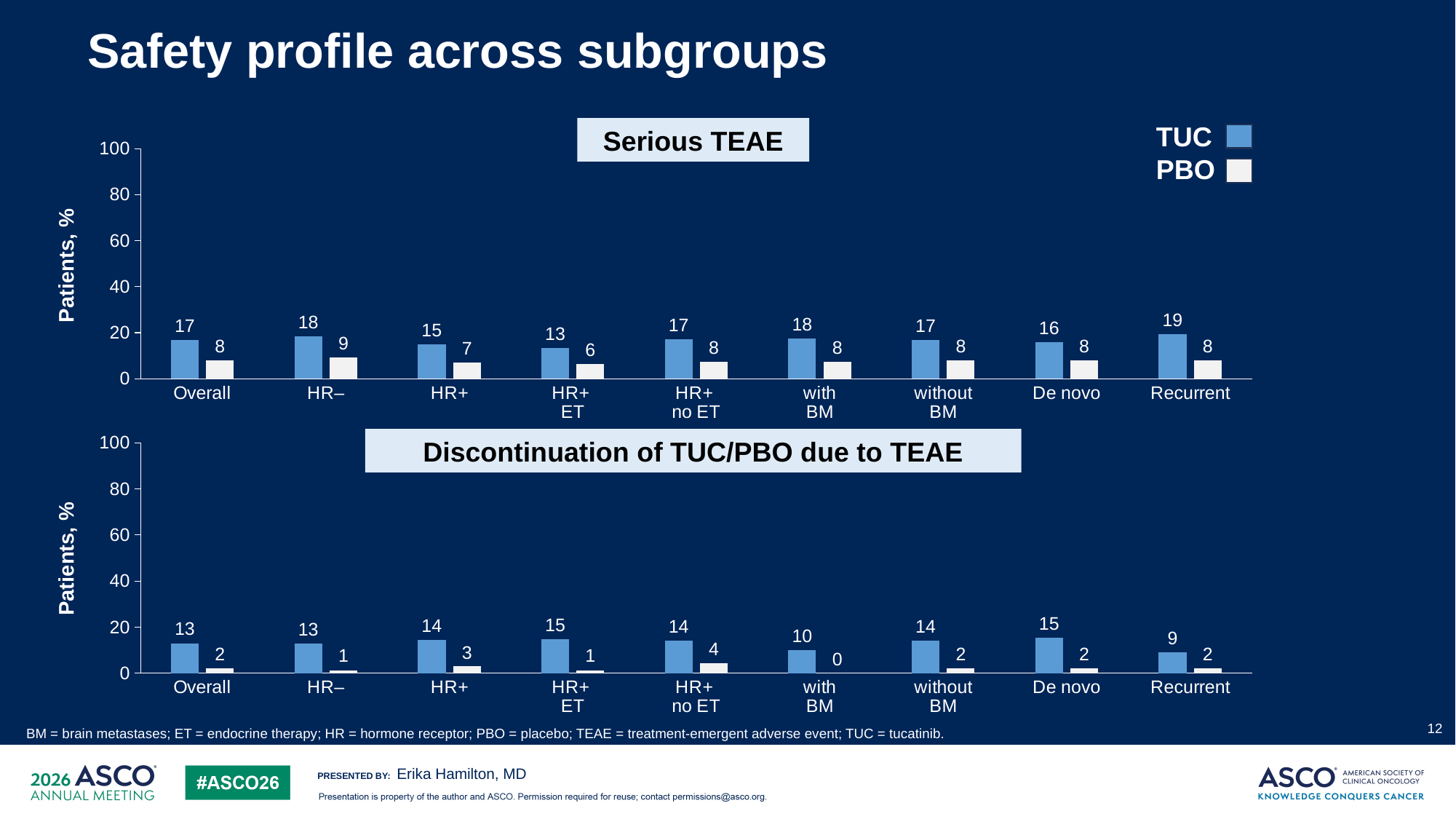
What kind of chart is the Discontinuation of TUC/PBO due to TEAE chart? Bar chart How many subgroups are shown on the x axis of the Serious TEAE chart? 9 In the Discontinuation of TUC/PBO due to TEAE chart, which is larger, the TUC value for De novo or the TUC value for Recurrent? De novo How many series does the legend list? 2 In the Discontinuation of TUC/PBO due to TEAE chart, which subgroup has the lowest PBO value? with BM In the Serious TEAE chart, which subgroup has the highest TUC value? Recurrent In the Serious TEAE chart, what is the PBO value for the HR– subgroup? 9 In the Serious TEAE chart, what is the TUC value for the Overall group? 17 In the Discontinuation of TUC/PBO due to TEAE chart, what is the PBO value for the HR+ no ET subgroup? 4 In the Serious TEAE chart, what is the difference between the TUC and PBO values for the Recurrent subgroup? 11 In the Discontinuation of TUC/PBO due to TEAE chart, what is the TUC value for the with BM subgroup? 10 In the Serious TEAE chart, which subgroup has the lowest TUC value? HR+ ET